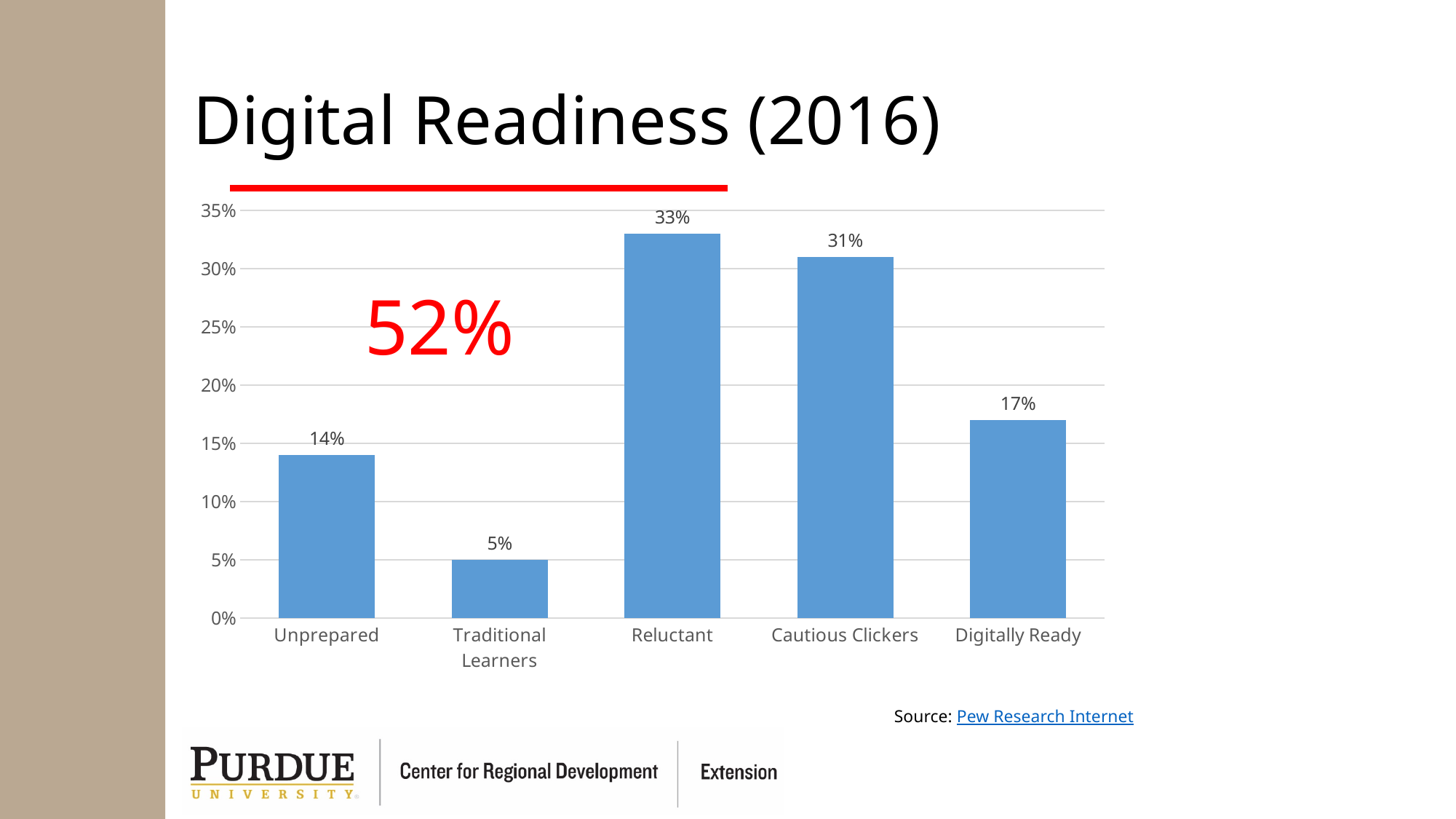
Which category has the highest value? Reluctant Is the value for Cautious Clickers greater or less than 30%? greater What kind of chart is shown on the slide? bar chart Which is larger, the value for Unprepared or the value for Digitally Ready? Digitally Ready What is the difference between the values for Reluctant and Cautious Clickers? 2% How many categories are shown on the x axis? 5 What is the value for Digitally Ready? 17% Which category has the lowest value? Traditional Learners What is the value for Traditional Learners? 5% What is the title of the slide containing the chart? Digital Readiness (2016) What is the value for Reluctant? 33% What is the difference between the values for Digitally Ready and Unprepared? 3%